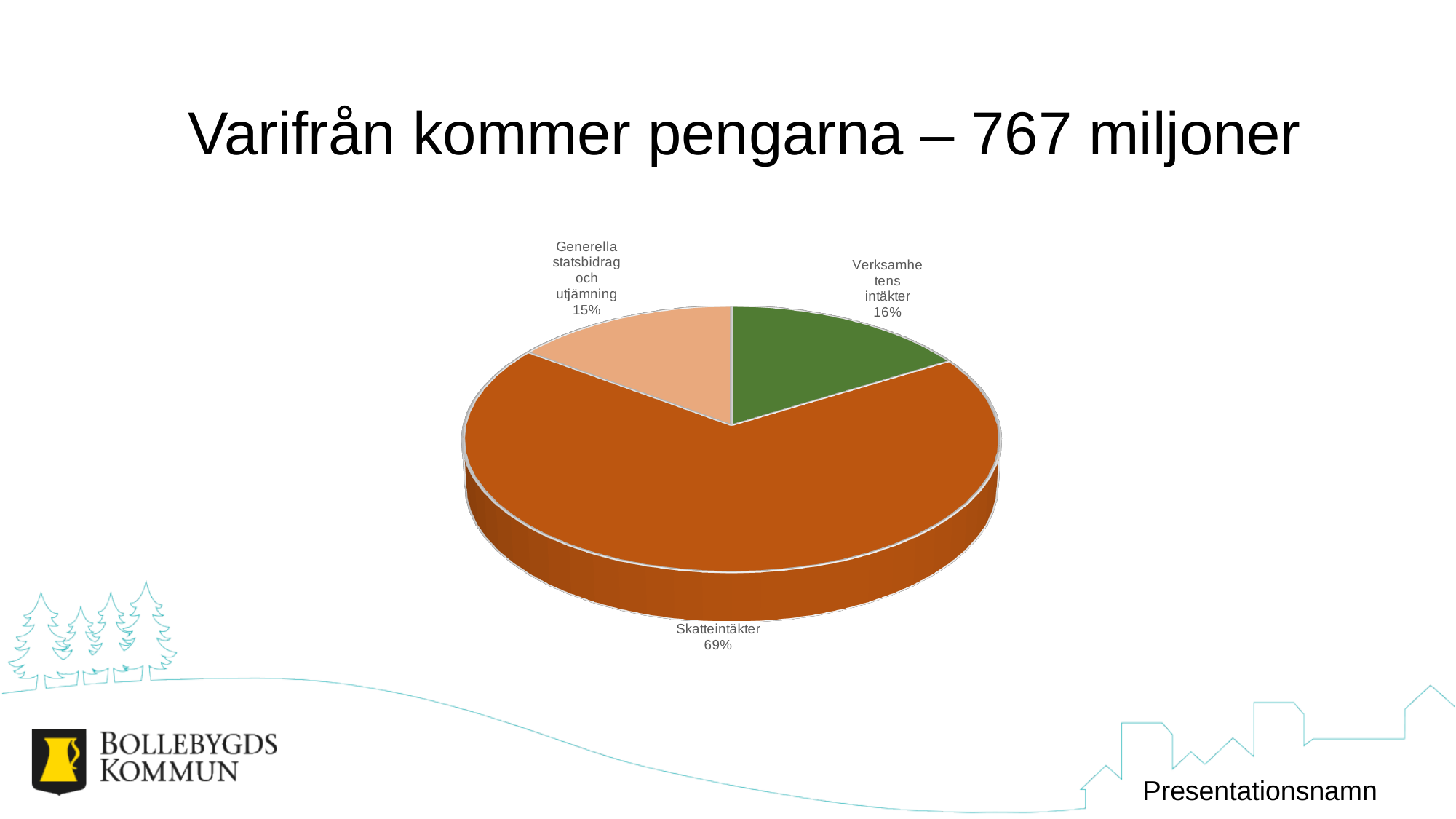
What share of the pie does Generella statsbidrag och utjämning represent? 15% Which category has the largest slice of the pie? Skatteintäkter What share of the pie does Verksamhetens intäkter represent? 16% What kind of chart is shown on the slide? pie chart What is the difference in percentage points between Skatteintäkter and Verksamhetens intäkter? 53 What is the title of the slide containing the chart? Varifrån kommer pengarna – 767 miljoner What share of the pie does Skatteintäkter represent? 69% What colour is the Skatteintäkter slice? orange What is the difference in percentage points between Verksamhetens intäkter and Generella statsbidrag och utjämning? 1 How many slices does the pie chart have? 3 Which category has the smallest slice of the pie? Generella statsbidrag och utjämning Which is larger, the share for Verksamhetens intäkter or the share for Generella statsbidrag och utjämning? Verksamhetens intäkter